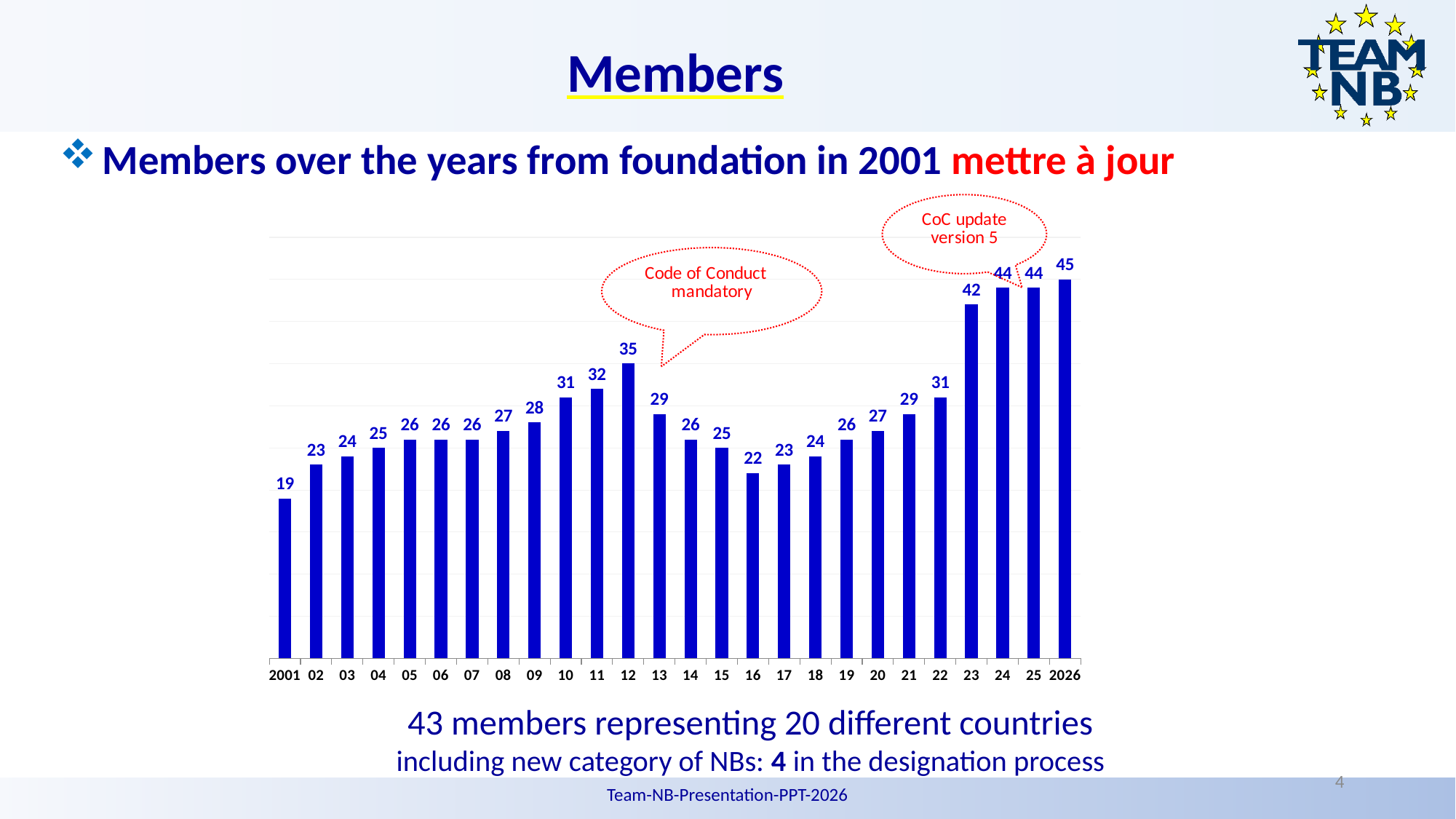
What is the difference between the values for 2026 and 2001? 26 What is the value shown for 2023? 42 What does the callout pointing at the 2012 bar say? Code of Conduct mandatory What is the value shown for 2012? 35 What is the difference between the values for 2012 and 2013? 6 What kind of chart is shown on the slide? bar chart How many members are shown for 2001? 19 What is the value shown for 2016? 22 How many years (bars) are plotted in the chart? 26 Which is larger, the value for 2012 or the value for 2022? 2012 Which year has the highest value in the chart? 2026 Which year has the lowest value in the chart? 2001